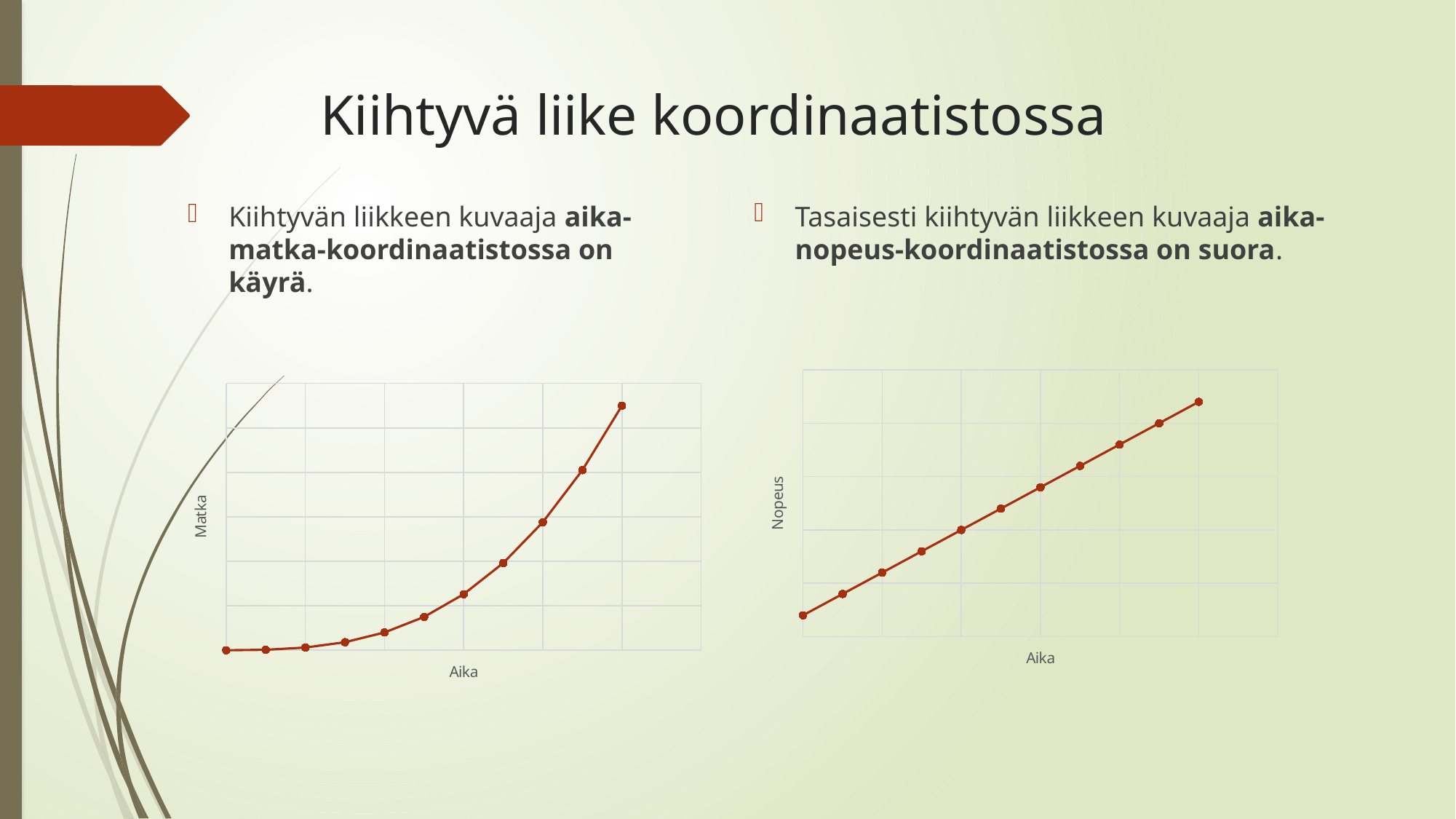
What kind of chart is the left chart (with y axis labelled Matka)? line chart In the left chart (Matka vs Aika), do the values rise or fall along the x axis? rise What is the label of the horizontal axis of the right chart? Aika How many data points are plotted in the right chart (Nopeus vs Aika)? 11 In the left chart (Matka vs Aika), is the line straight or curved? curved What is the label of the vertical axis of the left chart? Matka How many data points are plotted in the left chart (Matka vs Aika)? 11 What kind of chart is the right chart (with y axis labelled Nopeus)? line chart In the right chart (Nopeus vs Aika), is the line straight or curved? straight